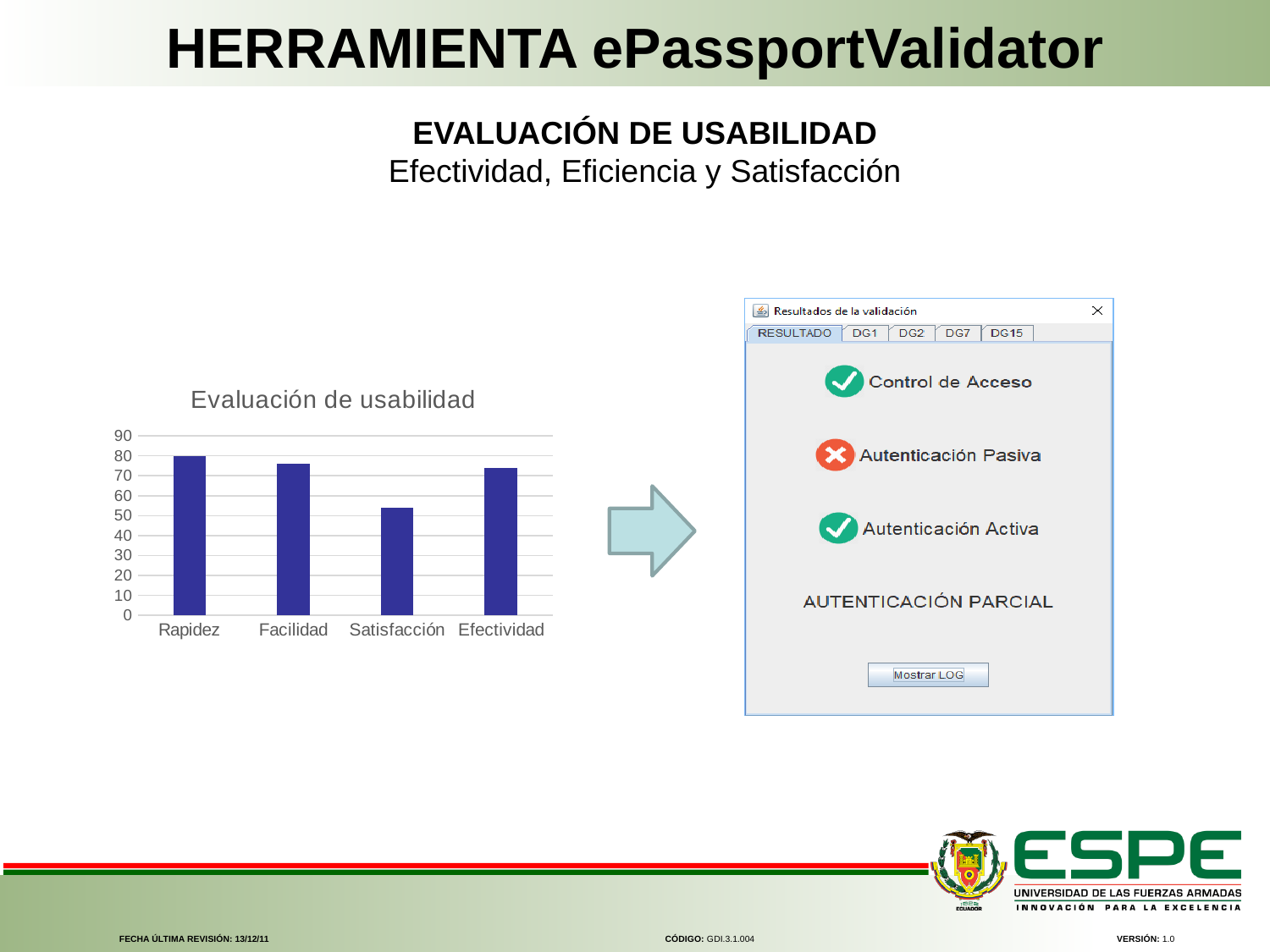
Is the value for Facilidad greater or less than 70? greater How many categories are shown on the x axis of the chart? 4 Is the value for Satisfacción greater or less than 60? less What is the title of the chart on the slide? Evaluación de usabilidad Which is larger, the value for Facilidad or the value for Satisfacción? Facilidad Which category has the highest value in the chart? Rapidez Which category has the lowest value in the chart? Satisfacción What kind of chart is shown on the slide? bar chart Which is larger, the value for Rapidez or the value for Satisfacción? Rapidez What is the highest value shown on the vertical axis of the chart? 90 Is the value for Rapidez greater or less than 90? less